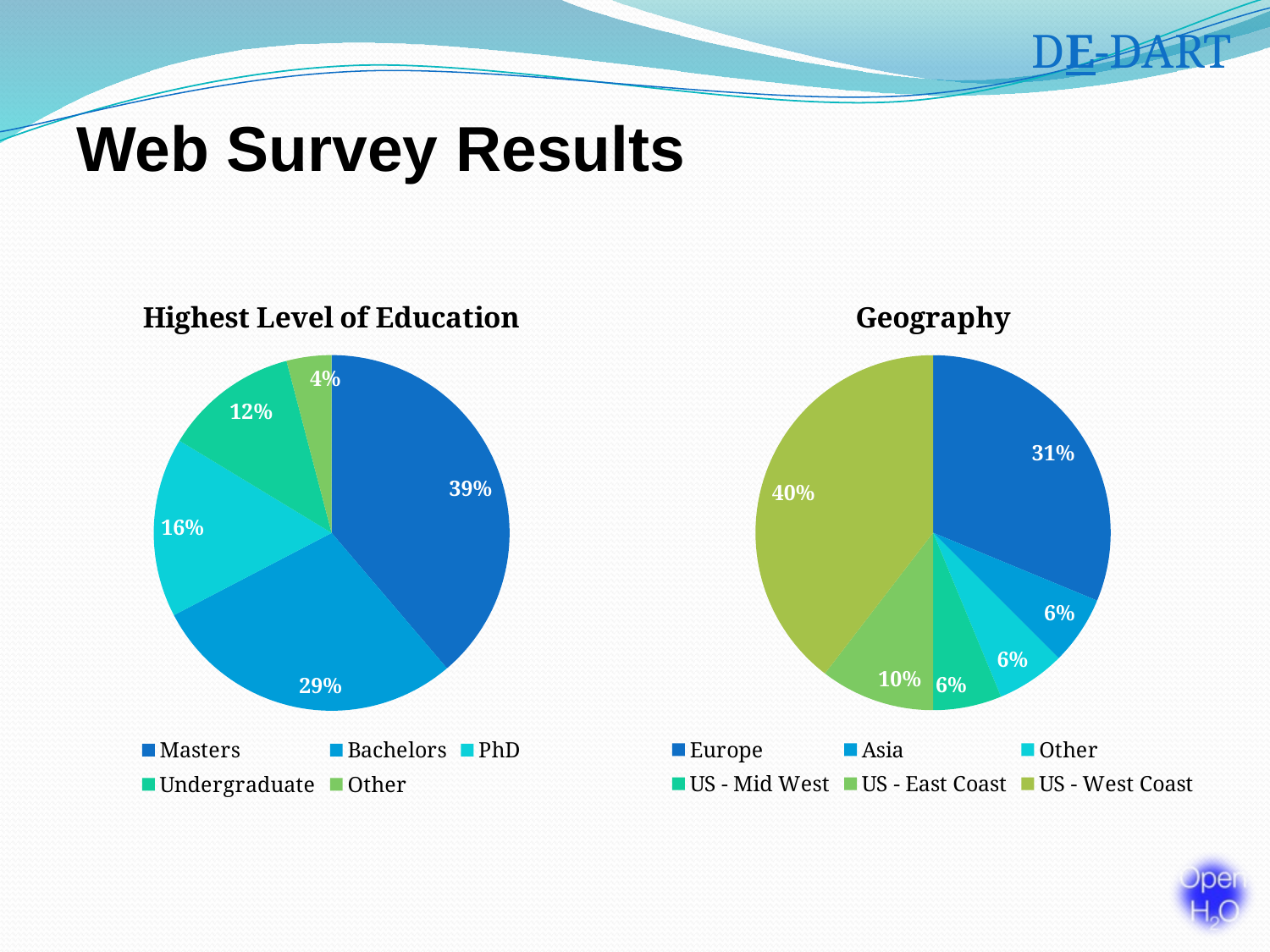
In the Highest Level of Education chart, which category has the smallest slice? Other In the Geography chart, what share of respondents are from Europe? 31% In the Highest Level of Education chart, which category has the largest slice? Masters What type of chart is used for the Geography data? Pie chart In the Geography chart, which region has the largest share? US - West Coast In the Highest Level of Education chart, what share of respondents have a Masters? 39% In the Geography chart, what percentage is shown for US - East Coast? 10% In the Geography chart, which is larger, the share for Europe or the share for US - West Coast? US - West Coast In the Highest Level of Education chart, what percentage is shown for PhD? 16% In the Highest Level of Education chart, what is the difference between the Masters and Bachelors shares? 10% In the Geography chart, how many regions does the legend list? 6 In the Highest Level of Education chart, how many categories does the legend list? 5